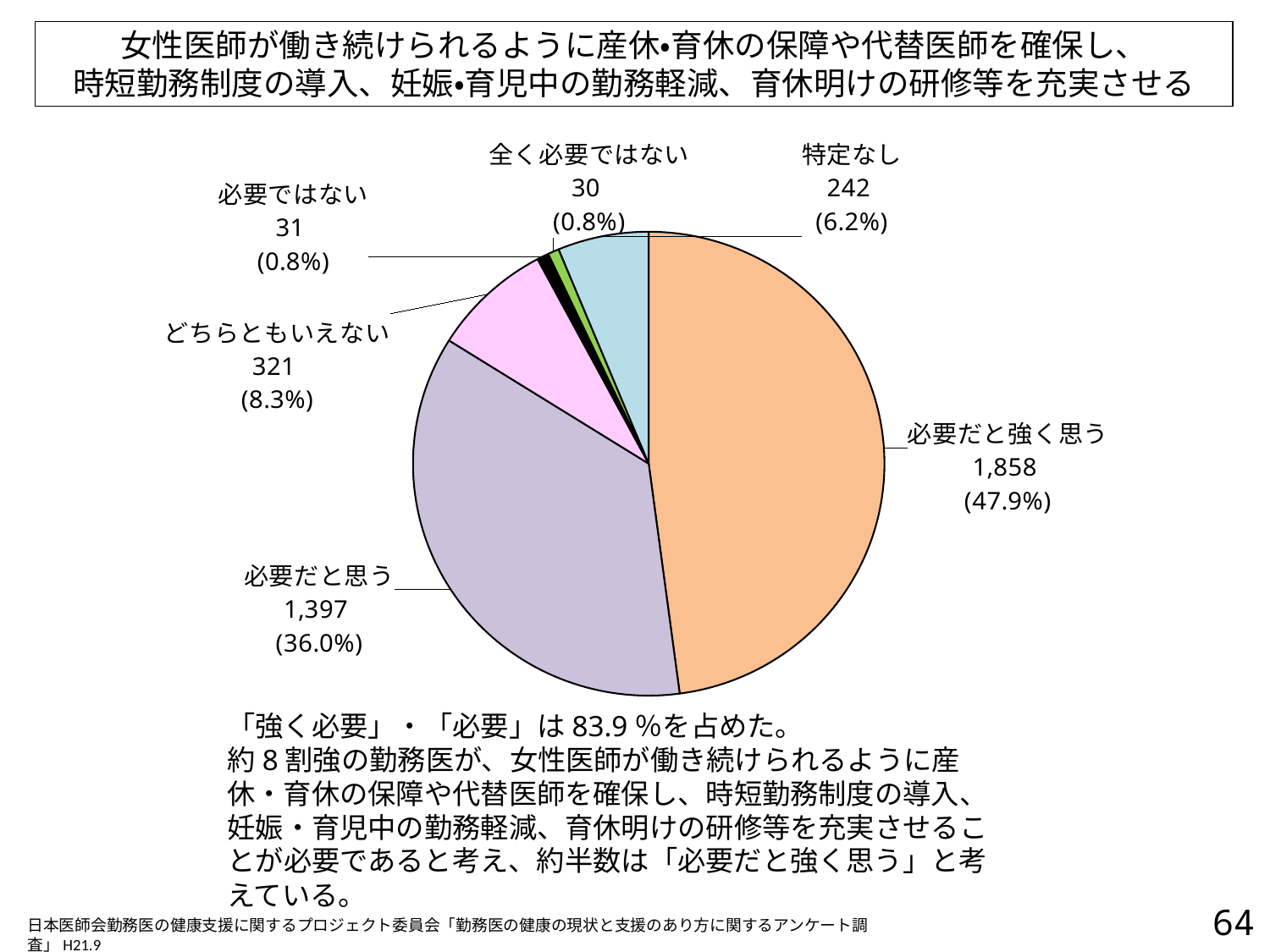
What kind of chart is shown on the slide? pie chart What is the value for 必要だと強く思う? 1,858 Which is larger, the value for どちらともいえない or the value for 特定なし? どちらともいえない What percentage share does 必要だと思う have? 36.0% Which category has the largest slice of the pie? 必要だと強く思う What is the value for 必要ではない? 31 What percentage share does 特定なし have? 6.2% What is the value for どちらともいえない? 321 What is the difference between the values for 必要だと強く思う and 必要だと思う? 461 What percentage share does 全く必要ではない have? 0.8% How many categories does the pie chart have? 6 What colour is the slice for 必要だと強く思う? orange